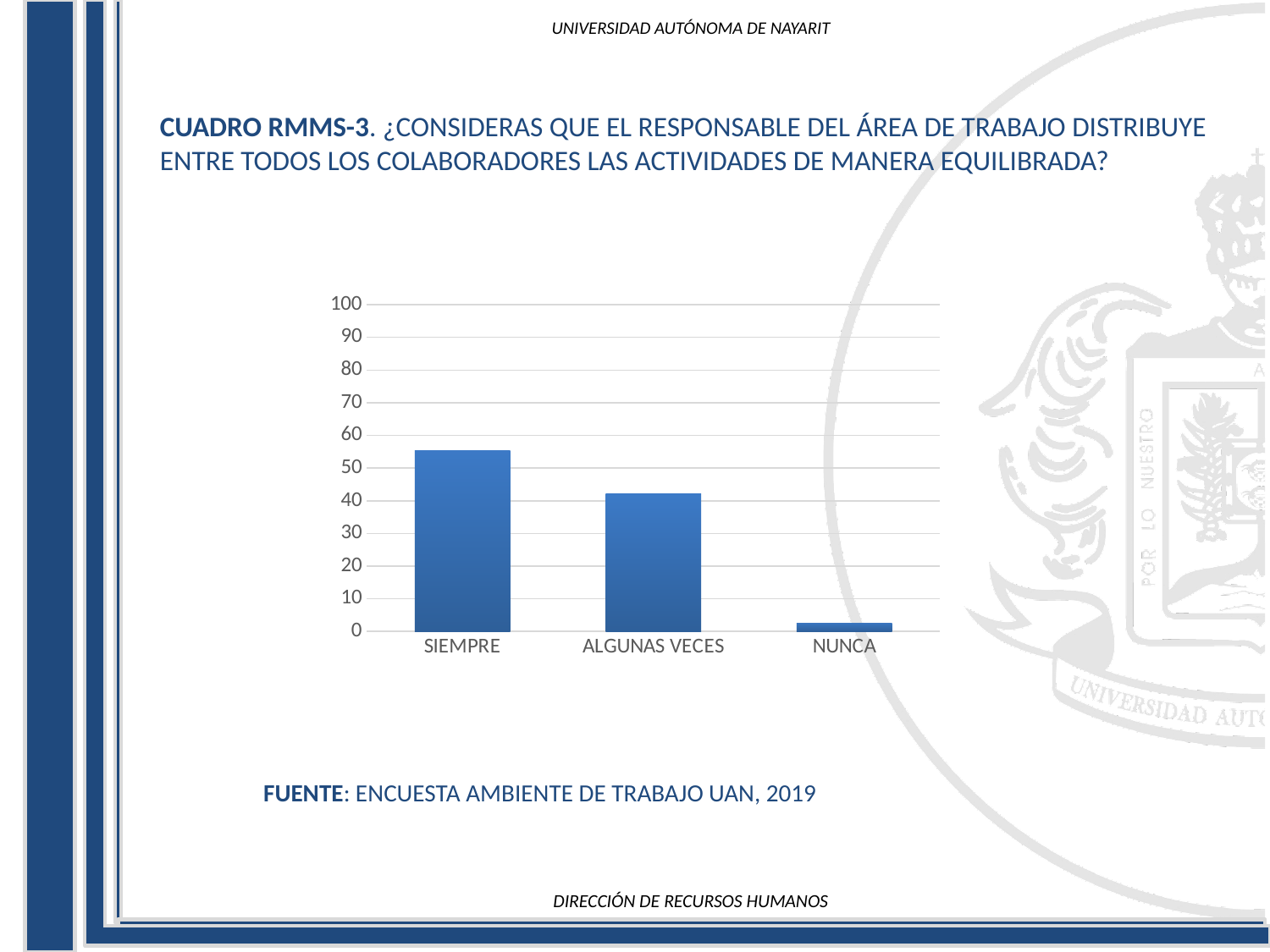
Which category has the lowest value in the chart? NUNCA Which is larger, the value for SIEMPRE or the value for ALGUNAS VECES? SIEMPRE Is the value for SIEMPRE greater or less than 50? greater Is the value for ALGUNAS VECES greater or less than 40? greater Which is larger, the value for ALGUNAS VECES or the value for NUNCA? ALGUNAS VECES What kind of chart is shown on the slide? bar chart Is the value for ALGUNAS VECES greater or less than 50? less Do the values rise or fall from left to right along the x axis? fall How many categories are shown on the x axis of the chart? 3 Which category has the highest value in the chart? SIEMPRE What is the maximum value shown on the vertical axis of the chart? 100